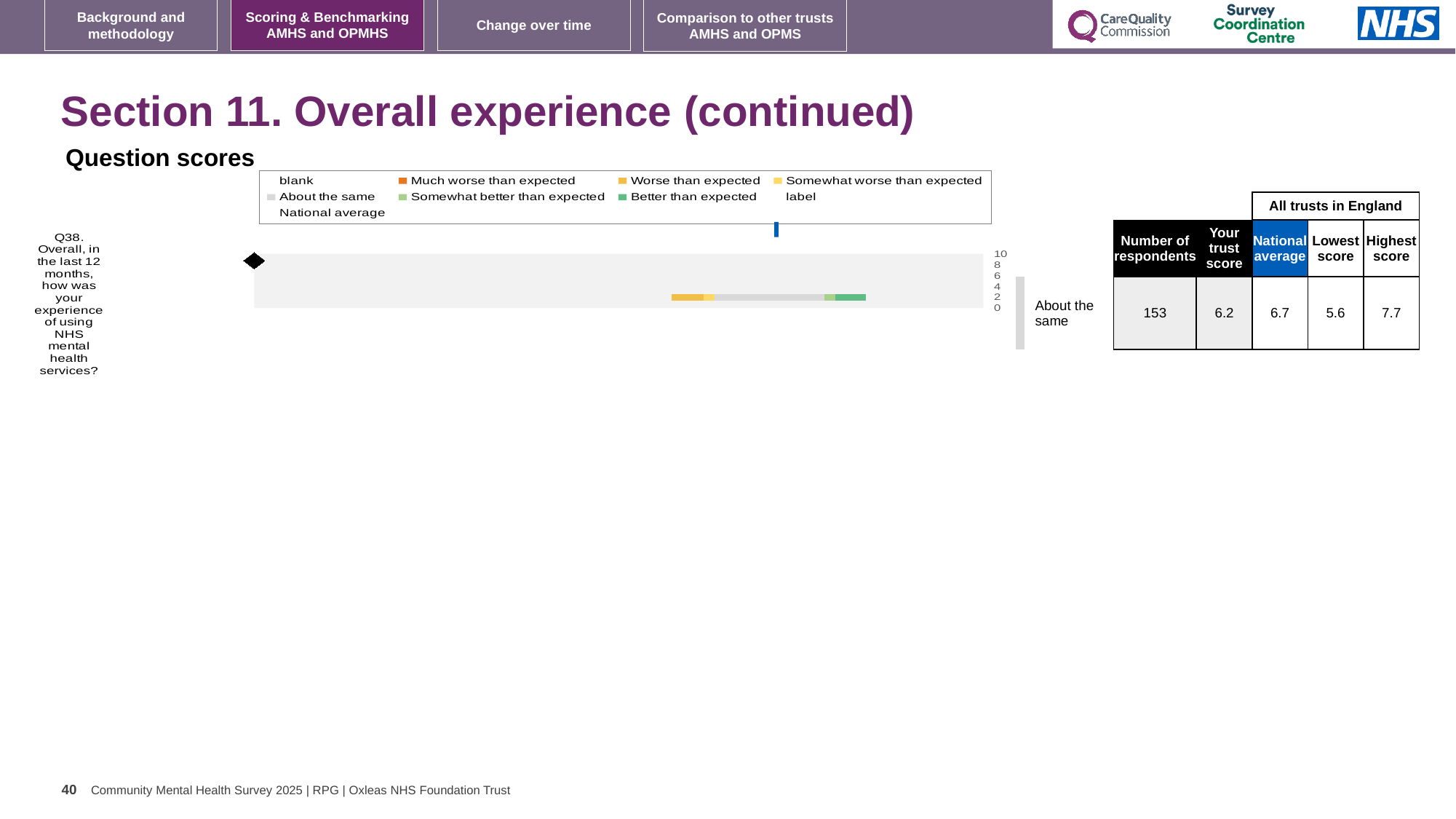
What is the highest score among all trusts in England for Q38? 7.7 Which colour in the legend represents "Much worse than expected"? orange What benchmark rating is given to Q38 next to the chart? About the same What is the difference between the national average (6.7) and the trust score (6.2) for Q38? 0.5 What is the lowest score among all trusts in England for Q38? 5.6 Which colour in the legend represents "Better than expected"? green What is the national average score for Q38 shown in the table beside the chart? 6.7 How many respondents answered Q38? 153 What kind of chart is shown on the slide? bar chart For Q38, which is larger: the trust score or the national average? national average How many questions (categories) are plotted in the chart? 1 What is the trust score for Q38 shown in the table beside the chart? 6.2